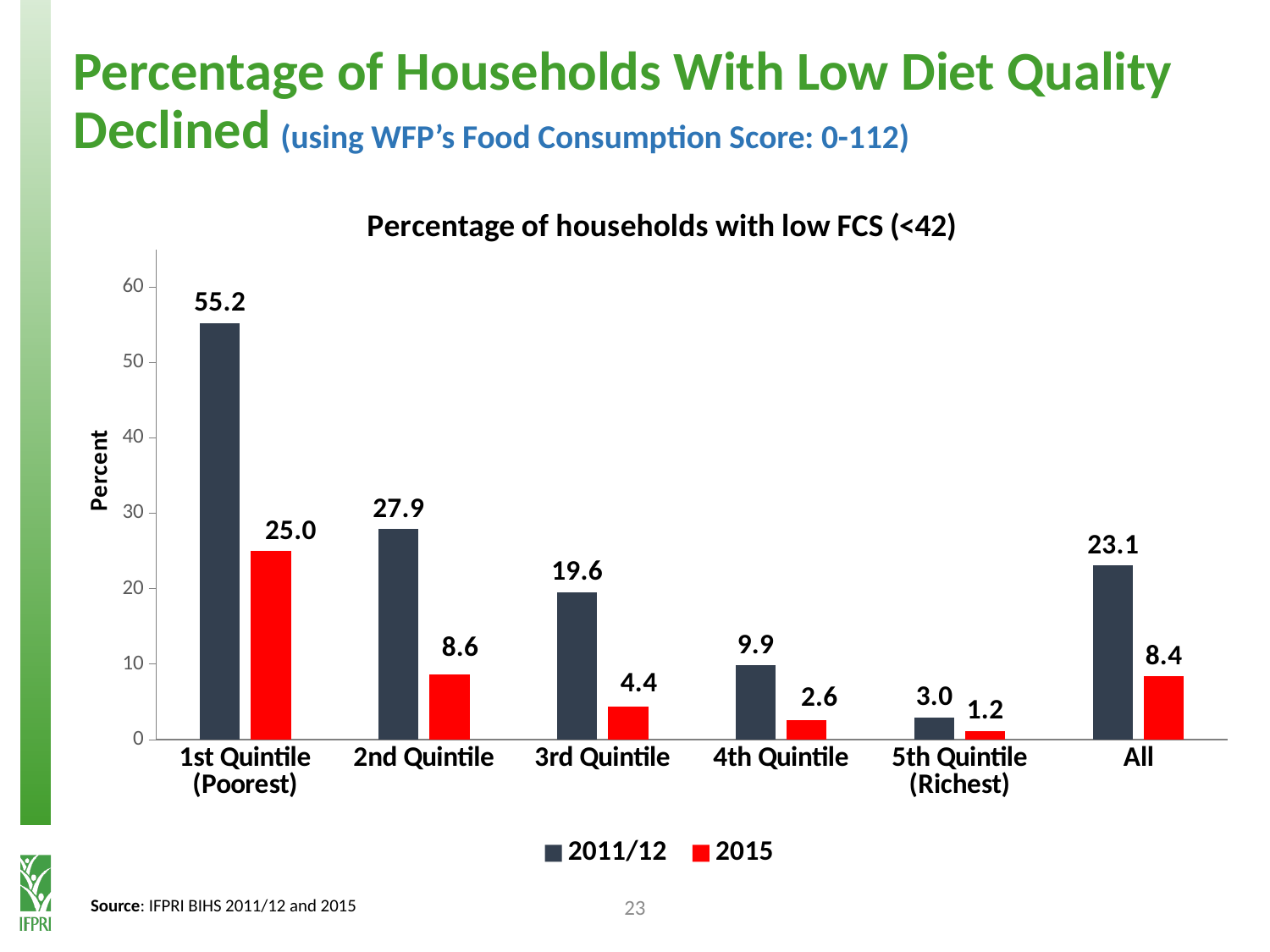
What kind of chart is shown? bar chart What is the value for the 1st Quintile (Poorest) in 2011/12? 55.2 What is the value for All in 2015? 8.4 How many categories are shown on the x axis? 6 Which category has the lowest value in 2015? 5th Quintile (Richest) How many series does the legend list? 2 Is the 2011/12 value for the 4th Quintile greater or less than 10? less What is the title of the chart? Percentage of households with low FCS (<42) Which is larger: the 2015 value for the 1st Quintile (Poorest) or the 2011/12 value for All? 2015 value for the 1st Quintile (Poorest) What is the value for the 3rd Quintile in 2015? 4.4 What is the difference between the 2011/12 and 2015 values for the 2nd Quintile? 19.3 Which category has the highest value in 2011/12? 1st Quintile (Poorest)